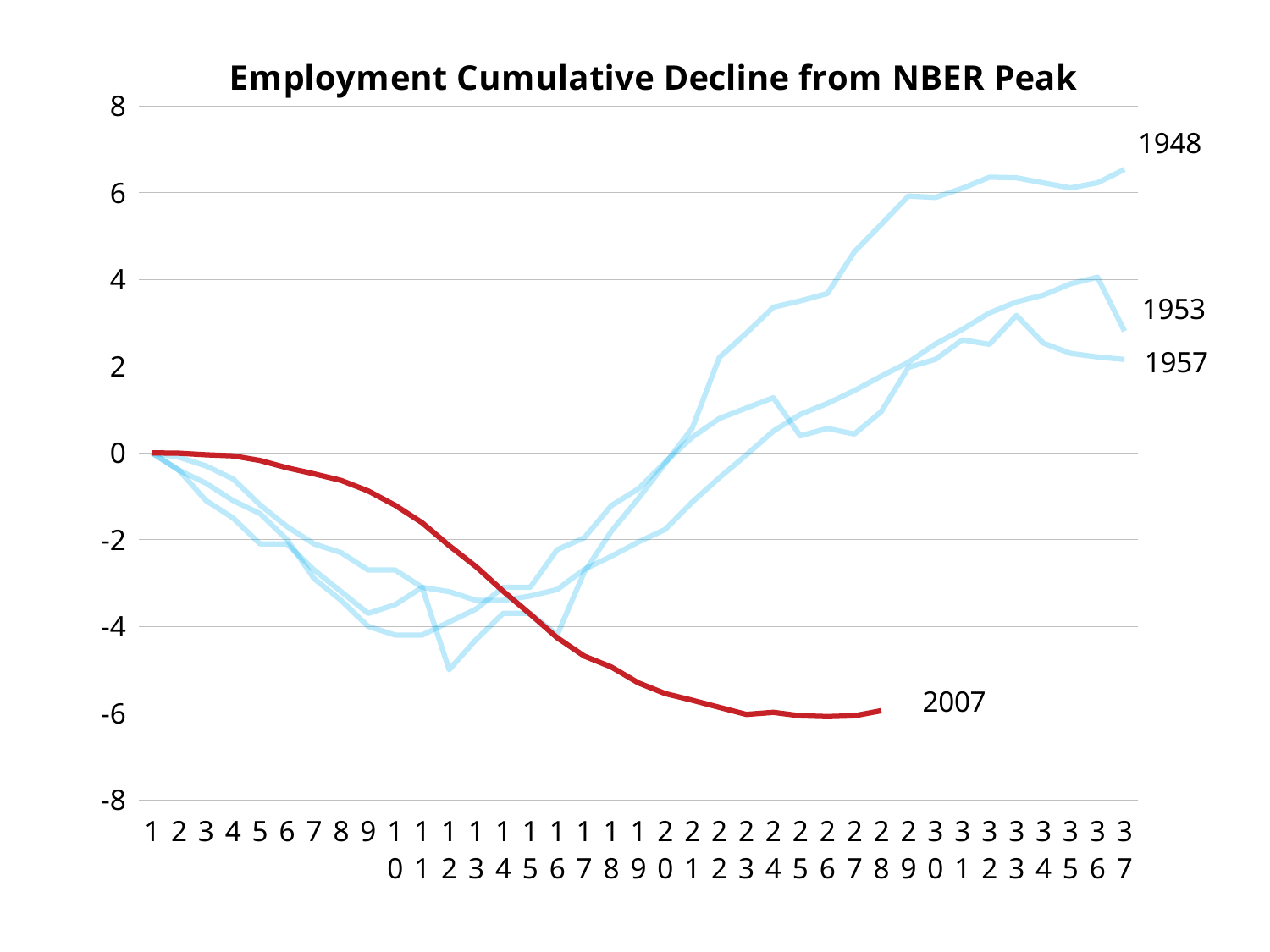
Which series reaches the lowest value on the chart? 2007 What kind of chart is shown on the slide? line chart Which series is drawn in red? 2007 What is the title of the chart? Employment Cumulative Decline from NBER Peak Does the 2007 series rise or fall from point 1 to point 28? fall Is the value of the 1953 series at point 37 greater or less than 2? greater How many points does the x axis run to? 37 Is the value of the 1948 series at point 37 greater or less than 4? greater How many series are plotted on the chart? 4 Is the value of the 2007 series at point 28 greater or less than -4? less What is the value of the 2007 series at point 1? 0 Which series has the highest value at point 37? 1948